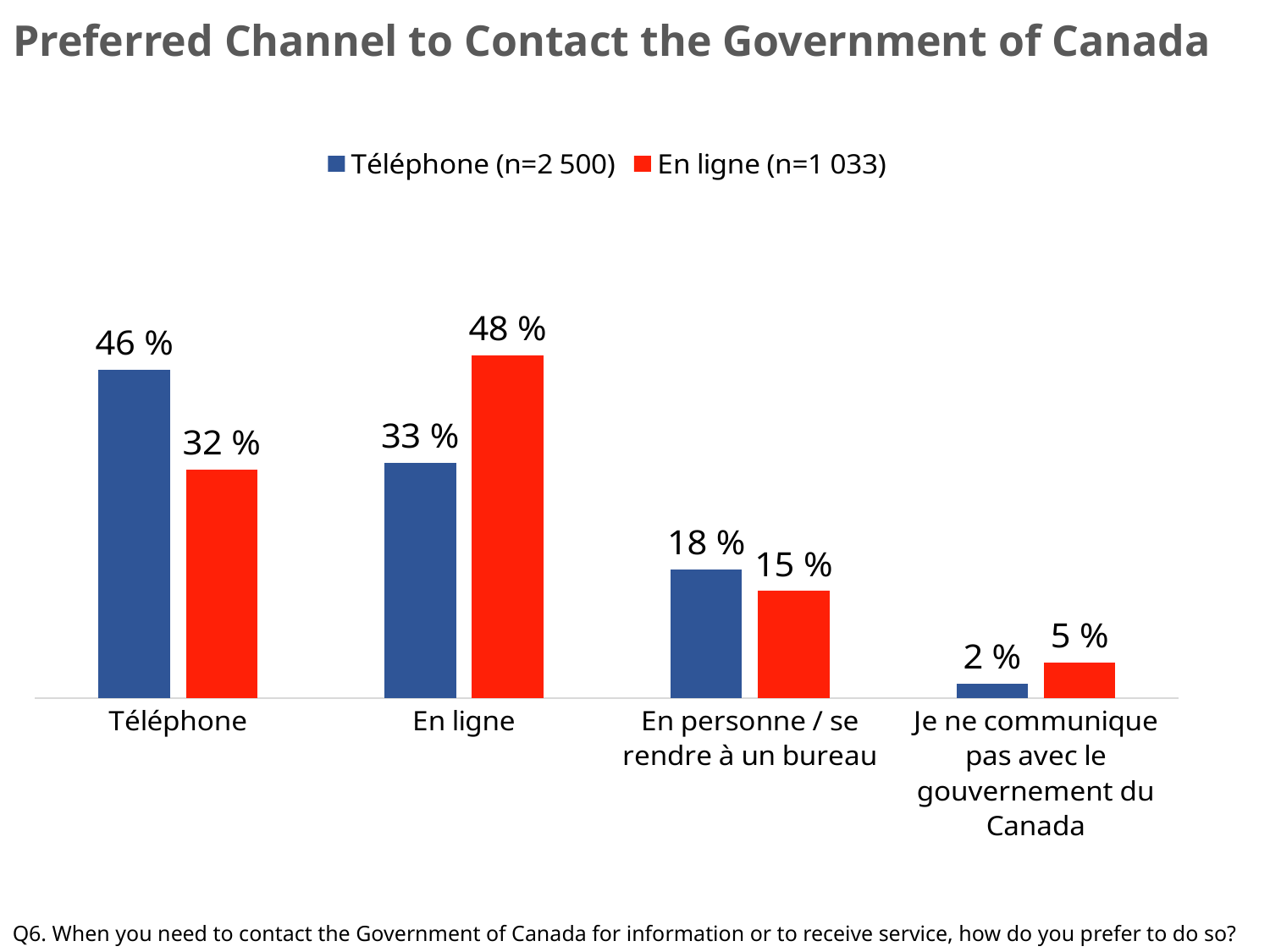
For the En ligne category, which series has the larger value: Téléphone (n=2 500) or En ligne (n=1 033)? En ligne (n=1 033) What is the difference between the Téléphone (n=2 500) and En ligne (n=1 033) values for the Téléphone category? 14 % How many categories are shown on the x axis? 4 How many series does the legend list? 2 What is the value for En personne / se rendre à un bureau in the Téléphone (n=2 500) series? 18 % Which category has the lowest value in the Téléphone (n=2 500) series? Je ne communique pas avec le gouvernement du Canada What kind of chart is shown on the slide? Bar chart What is the title of the chart? Preferred Channel to Contact the Government of Canada What is the value for Téléphone in the Téléphone (n=2 500) series? 46 % Which category has the highest value in the En ligne (n=1 033) series? En ligne What is the value for Je ne communique pas avec le gouvernement du Canada in the En ligne (n=1 033) series? 5 % What is the value for En ligne in the En ligne (n=1 033) series? 48 %